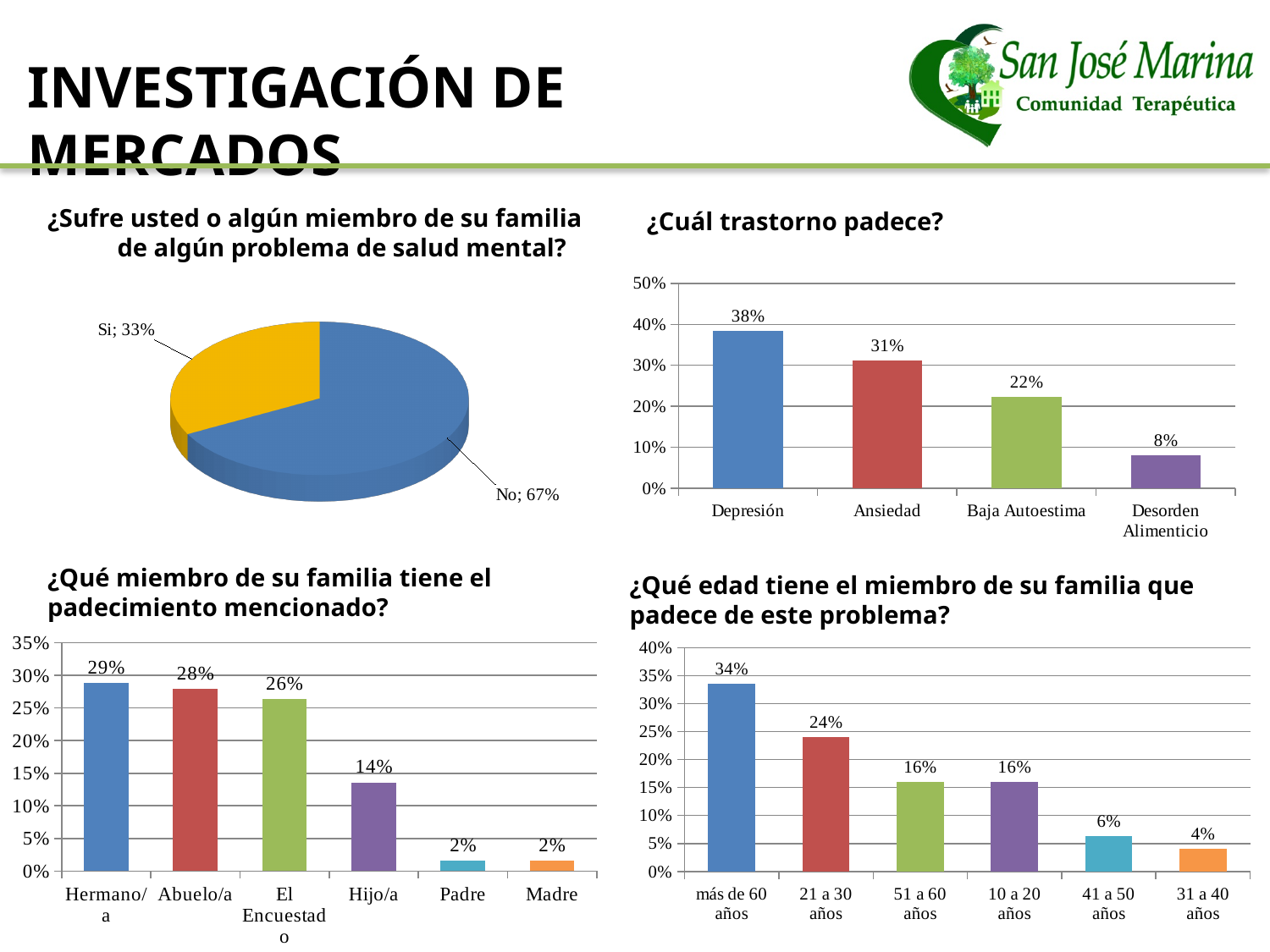
In the pie chart '¿Sufre usted o algún miembro de su familia de algún problema de salud mental?', what share is labelled 'No'? 67% In the chart '¿Cuál trastorno padece?', which category has the highest value? Depresión In the chart '¿Cuál trastorno padece?', what is the value for Ansiedad? 31% In the chart '¿Qué miembro de su familia tiene el padecimiento mencionado?', which is larger, Hermano/a or El Encuestado? Hermano/a In the chart '¿Cuál trastorno padece?', what is the difference between Depresión and Desorden Alimenticio? 30% In the chart '¿Qué edad tiene el miembro de su familia que padece de este problema?', what is the value for '21 a 30 años'? 24% In the chart '¿Qué edad tiene el miembro de su familia que padece de este problema?', which category has the lowest value? 31 a 40 años In the chart '¿Qué miembro de su familia tiene el padecimiento mencionado?', how many categories are shown on the x axis? 6 What kind of chart is used for '¿Sufre usted o algún miembro de su familia de algún problema de salud mental?'? Pie chart In the pie chart '¿Sufre usted o algún miembro de su familia de algún problema de salud mental?', what share is labelled 'Si'? 33% In the chart '¿Qué miembro de su familia tiene el padecimiento mencionado?', what is the value for Hijo/a? 14% In the chart '¿Cuál trastorno padece?', how many categories are shown? 4